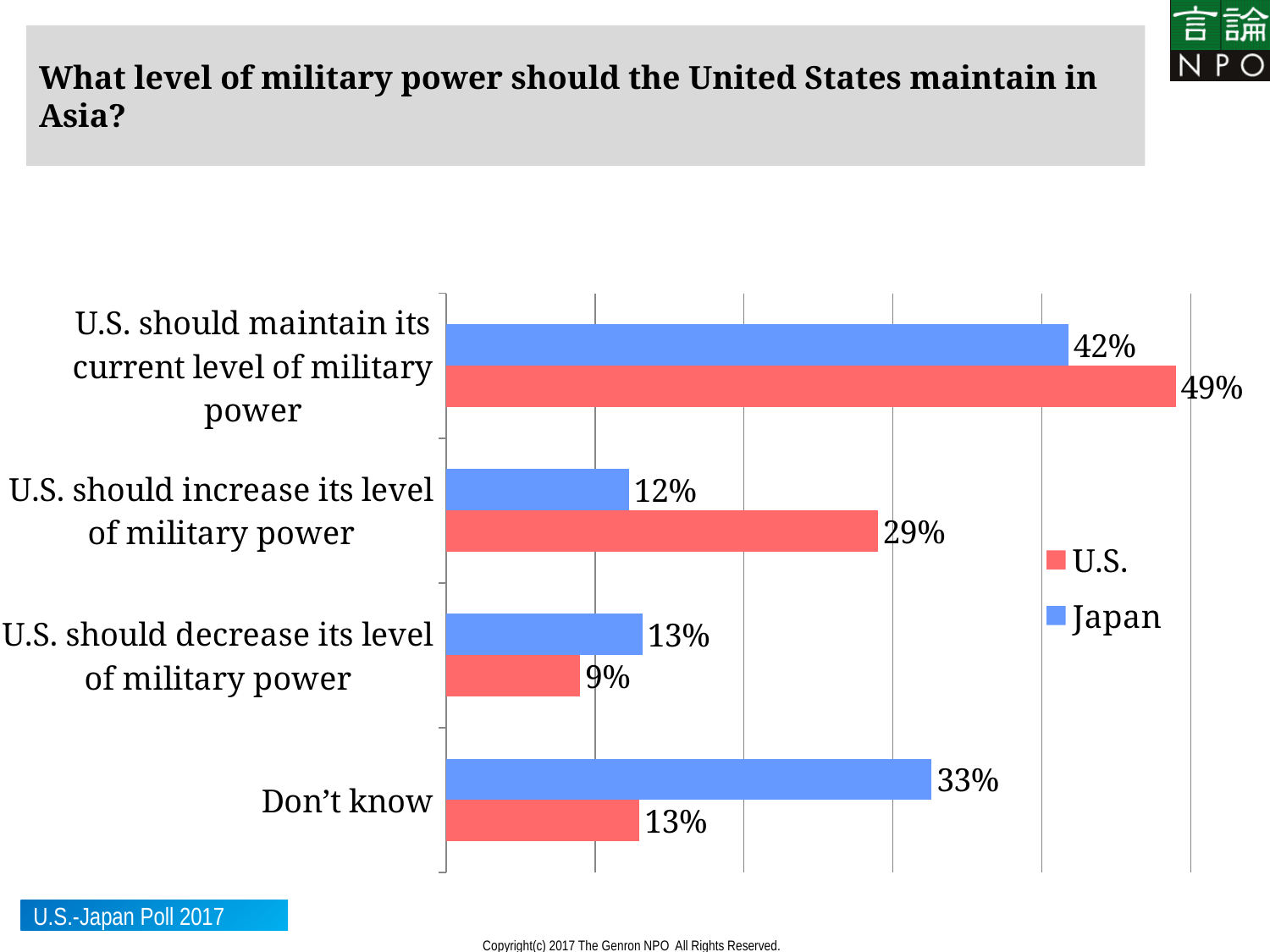
What percentage of U.S. respondents said the U.S. should maintain its current level of military power? 49% What percentage of U.S. respondents said the U.S. should decrease its level of military power? 9% How many response categories are shown on the chart? 4 What percentage of Japanese respondents said the U.S. should increase its level of military power? 12% What percentage of Japanese respondents answered 'Don't know'? 33% Which response option has the highest value for U.S. respondents? U.S. should maintain its current level of military power What kind of chart is shown on the slide? Bar chart Which colour represents Japan in the chart? Blue For 'Don't know', which series has the larger value, U.S. or Japan? Japan What is the difference between the U.S. and Japan values for 'U.S. should increase its level of military power'? 17 percentage points Which response option has the lowest value for Japanese respondents? U.S. should increase its level of military power How many series does the legend list? 2